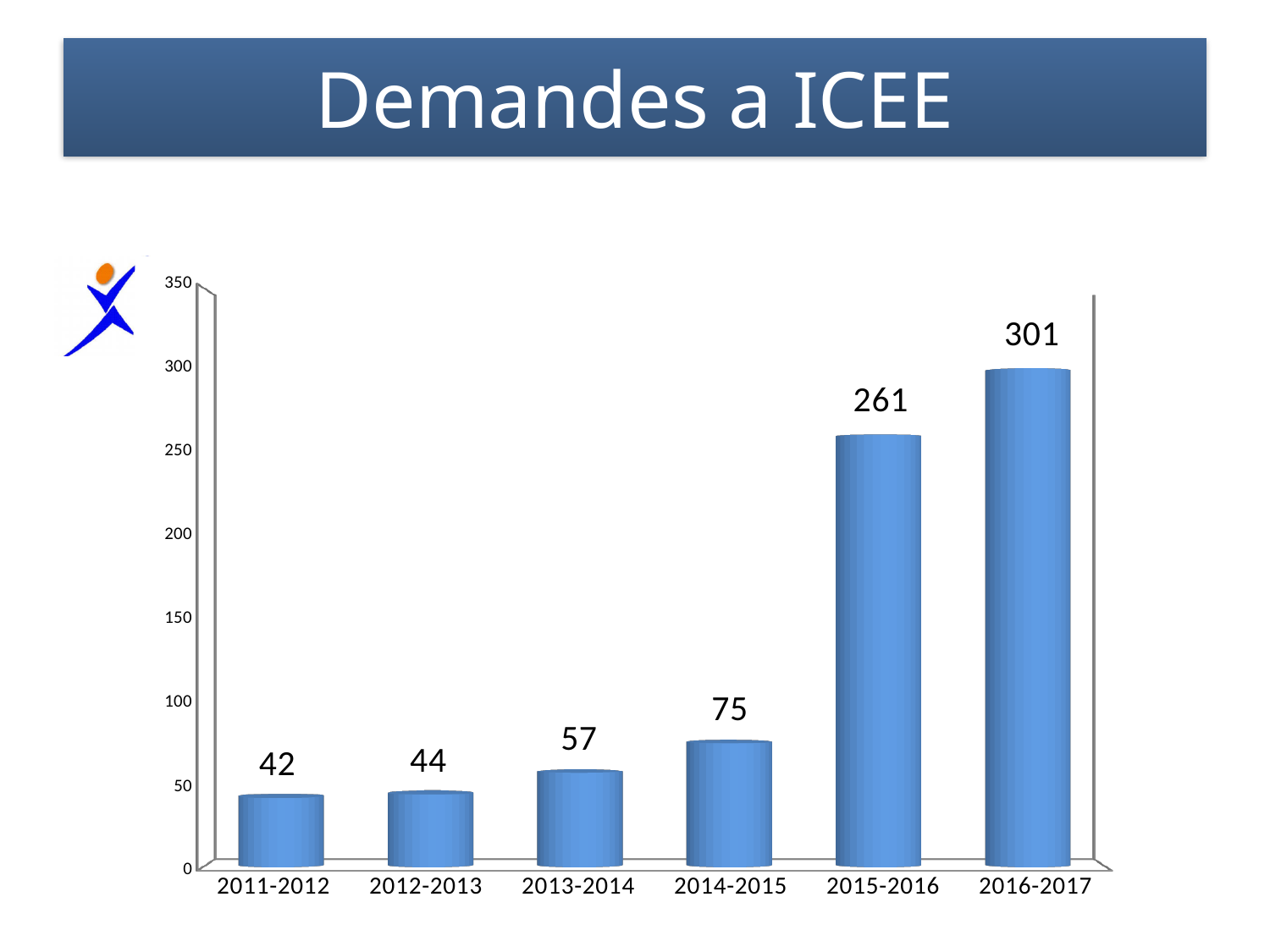
What is the difference between the values for 2014-2015 and 2013-2014? 18 What is the difference between the values for 2016-2017 and 2015-2016? 40 How many periods are shown on the x axis? 6 What is the value for 2014-2015? 75 Which period has the lowest value? 2011-2012 What is the value for 2016-2017? 301 Which is larger, the value for 2013-2014 or the value for 2012-2013? 2013-2014 Which period has the highest value? 2016-2017 What is the value for 2011-2012? 42 What kind of chart is shown on the slide? bar chart Is the value for 2015-2016 greater or less than 250? greater Do the values rise or fall from 2011-2012 to 2016-2017? rise